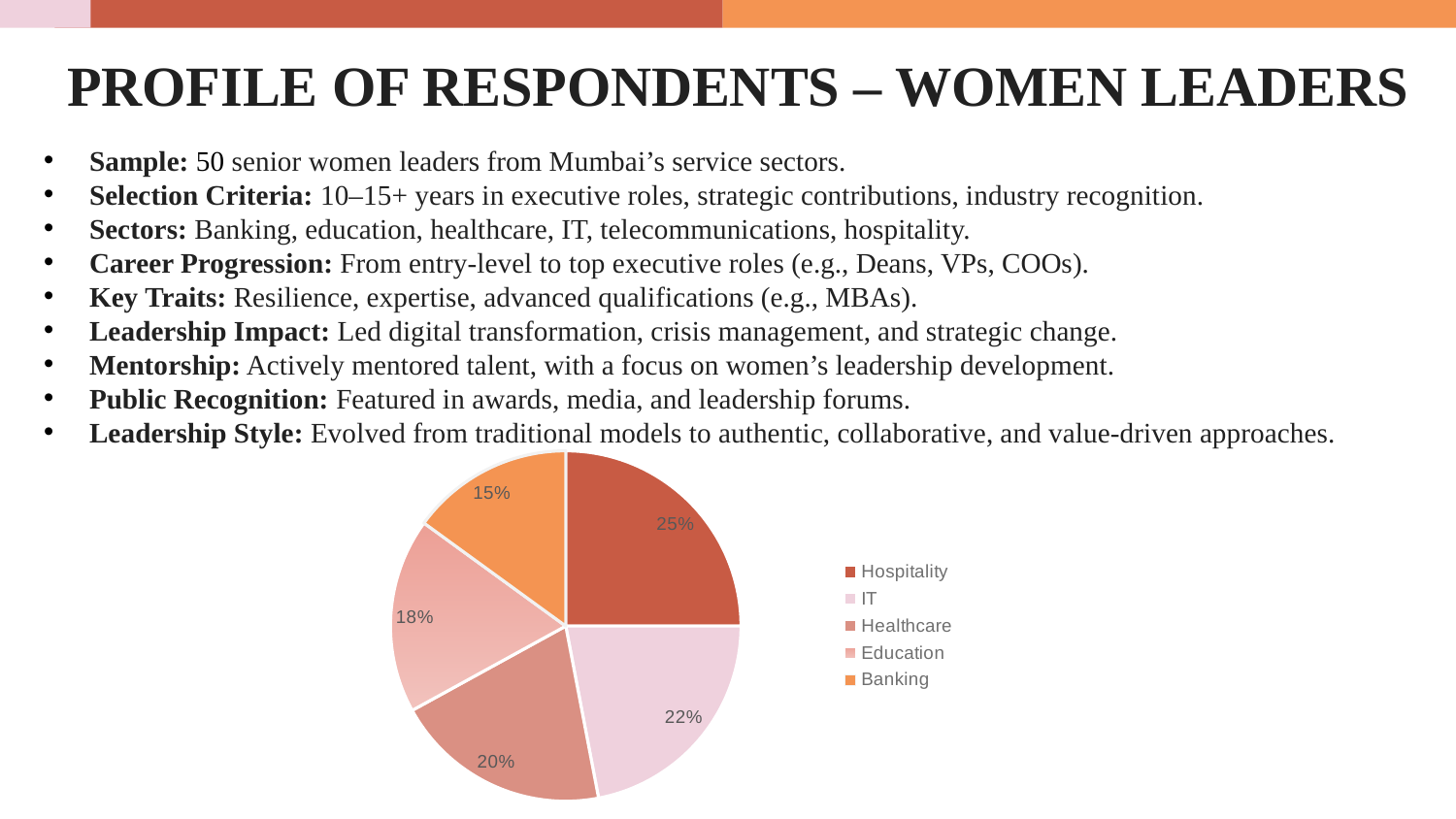
Which legend entry is shown in orange? Banking What share of the pie chart does Hospitality represent? 25% Which sector has the smallest slice of the pie chart? Banking What is the difference in percentage points between the IT and Education slices? 4 Which slice is larger, Education or Healthcare? Healthcare What is the difference in percentage points between the Hospitality and Banking slices? 10 What percentage of the pie chart is labelled for IT? 22% Which sector has the largest slice of the pie chart? Hospitality How many sectors are shown in the pie chart? 5 What is the value shown for Healthcare in the pie chart? 20% What type of chart is shown on the slide? Pie chart What percentage does the Banking slice show? 15%